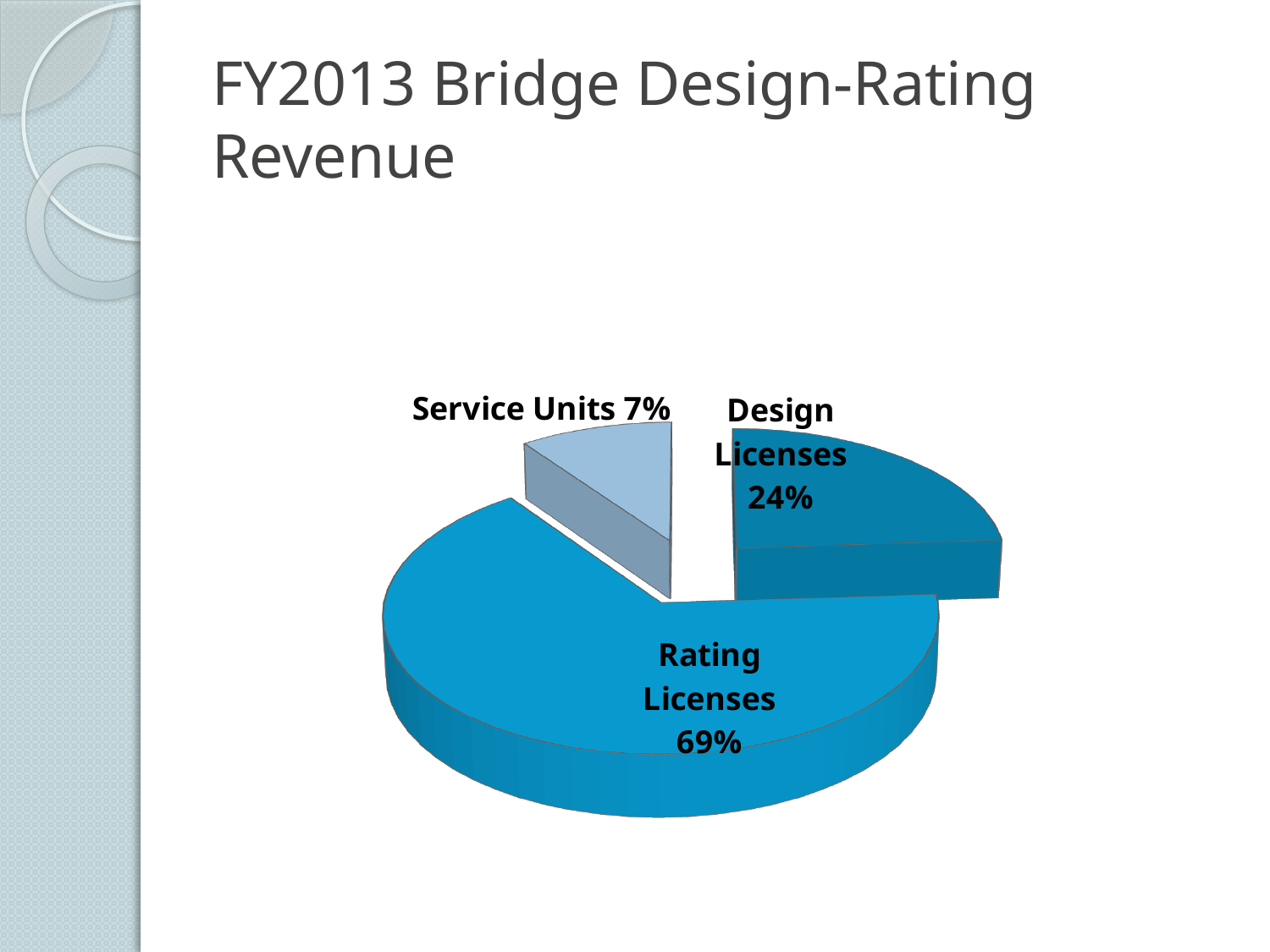
What share of revenue comes from Service Units? 7% How many categories are shown in the pie chart? 3 What share of revenue comes from Rating Licenses? 69% What is the difference in percentage points between Design Licenses and Service Units? 17 What is the title of the slide containing the pie chart? FY2013 Bridge Design-Rating Revenue What share of revenue comes from Design Licenses? 24% What is the difference in percentage points between Rating Licenses and Design Licenses? 45 Which is larger, the share for Design Licenses or the share for Service Units? Design Licenses Which category has the smallest share of revenue? Service Units Which category has the largest share of revenue? Rating Licenses What kind of chart is shown on the slide? Pie chart